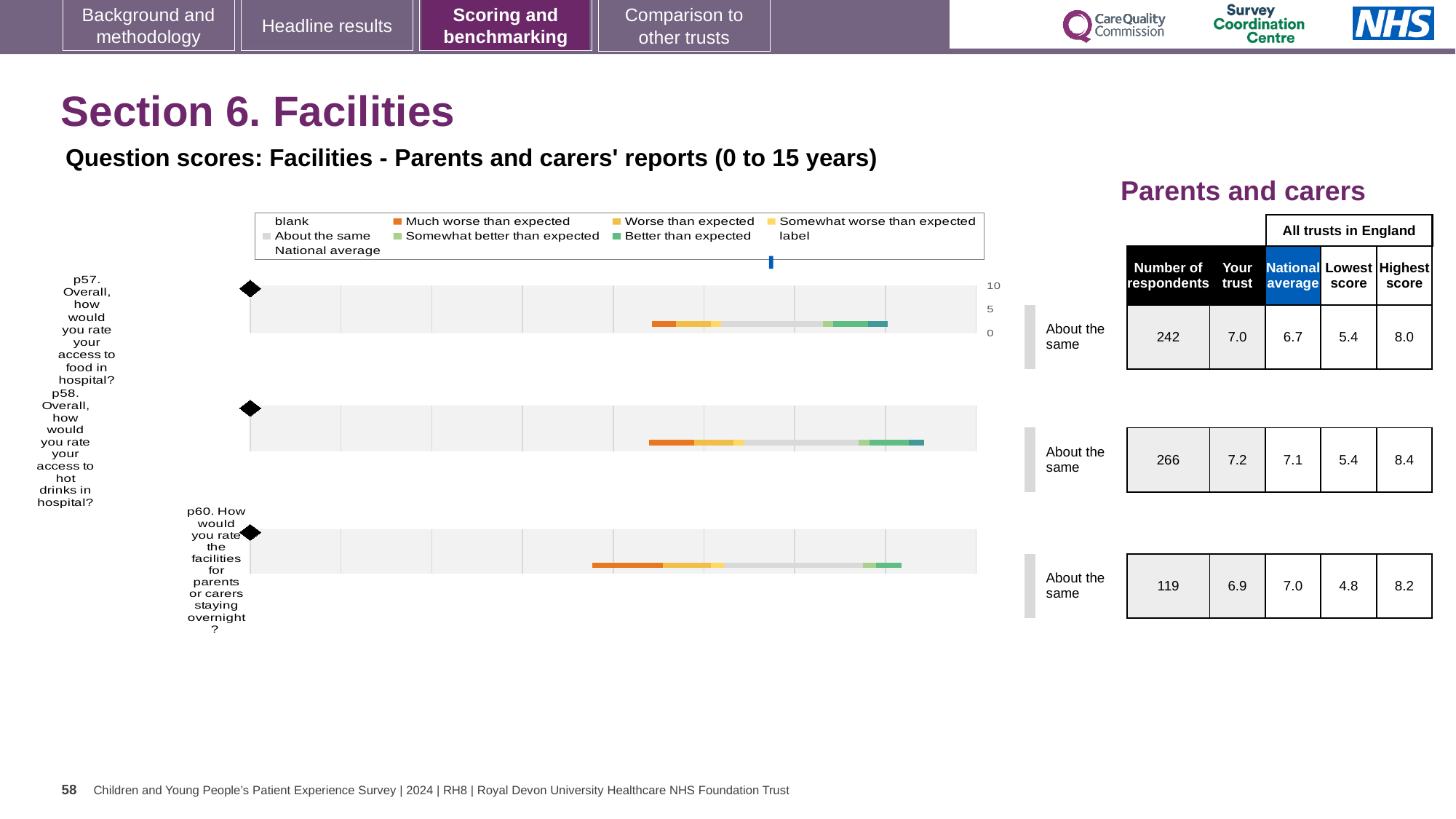
What benchmark category is shown for p60? About the same What colour does the legend use for 'Much worse than expected'? orange How many questions are plotted in the Facilities chart? 3 What is the national average score for p58 (access to hot drinks in hospital)? 7.1 What kind of chart is used to show the question scores for Facilities? bar chart What is the 'Your trust' score for p57 (access to food in hospital)? 7.0 What is the difference between the highest score and the lowest score for p57? 2.6 For p57, which is larger: the 'Your trust' score or the national average? Your trust Which question has the lowest 'Your trust' score? p60 How many respondents answered p60 (facilities for parents or carers staying overnight)? 119 Which question has the highest 'Your trust' score? p58 What is the highest score across all trusts in England for p58? 8.4